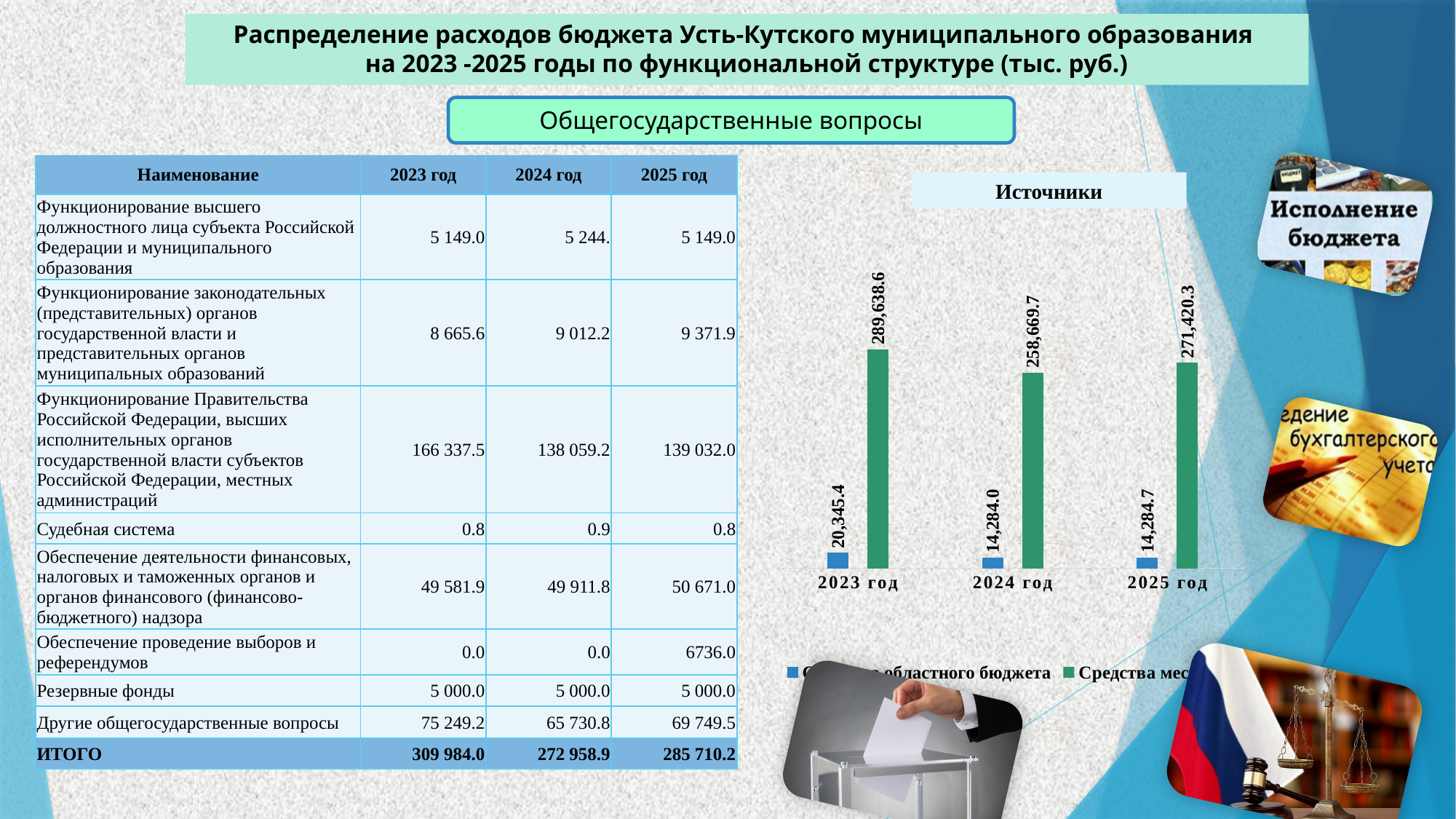
In the "Источники" chart, what is the value of the blue bar for 2024 год? 14,284.0 What type of chart is shown under the title "Источники"? bar chart In the "Источники" chart, which year has the lowest green bar? 2024 год In the "Источники" chart, what is the difference between the blue bar values for 2023 год and 2025 год? 6,060.7 How many series does the legend of the "Источники" chart list? 2 In the "Источники" chart, which year has the highest green bar? 2023 год In the "Источники" chart, what is the value of the green bar for 2023 год? 289,638.6 In the "Источники" chart, is the green bar for 2024 год larger or smaller than the green bar for 2025 год? smaller In the "Источники" chart, what is the value of the green bar for 2025 год? 271,420.3 How many year categories are shown on the x axis of the "Источники" chart? 3 In the "Источники" chart, what is the difference between the green bar values for 2023 год and 2024 год? 30,968.9 In the "Источники" chart, what is the value of the blue bar for 2023 год? 20,345.4